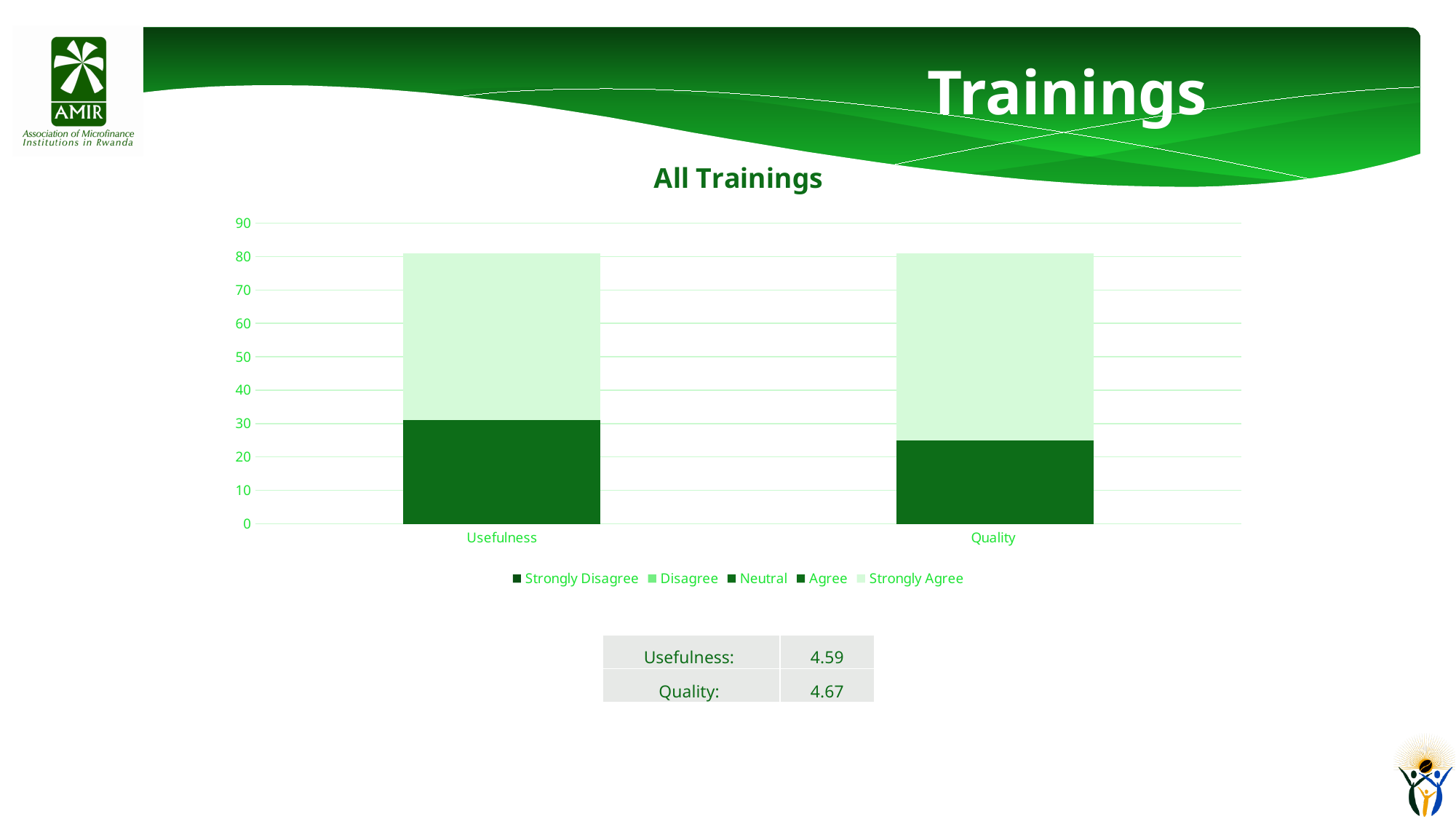
Which category has the larger Strongly Agree segment, Usefulness or Quality? Quality Which category has the larger Agree segment, Usefulness or Quality? Usefulness Is the total height of the Usefulness bar greater or less than 90? less Is the Agree value for Usefulness greater or less than 20? greater Which series is listed last in the legend of the "All Trainings" chart? Strongly Agree Is the Agree value for Quality greater or less than 20? greater What type of chart is shown under the title "All Trainings"? stacked bar chart How many categories are shown on the x axis of the "All Trainings" chart? 2 How many series does the legend of the "All Trainings" chart list? 5 What is the title of the chart on the slide? All Trainings